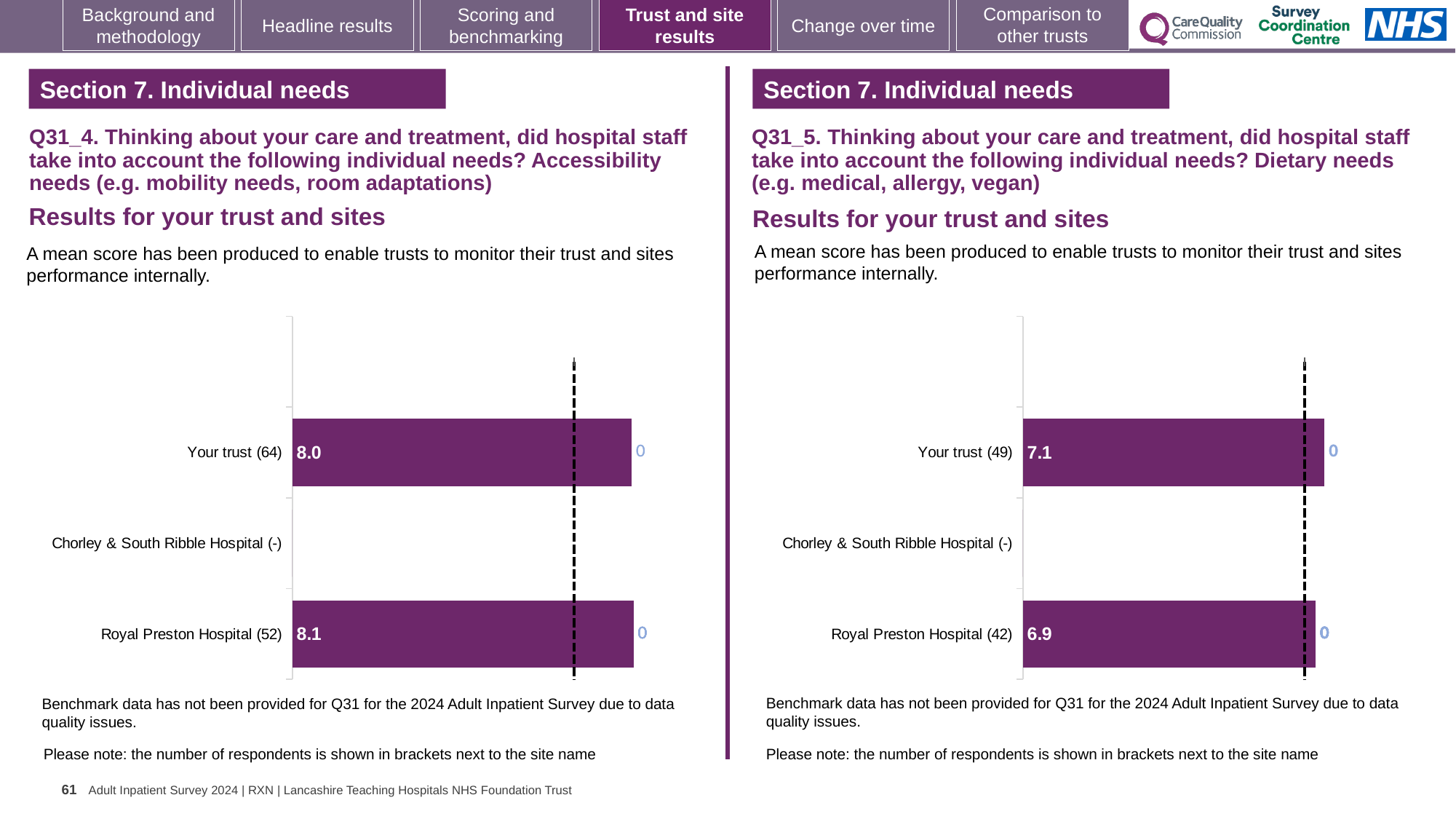
On the right chart (Q31_5, dietary needs), what is the mean score for Your trust? 7.1 On the right chart (Q31_5, dietary needs), how many respondents are shown in brackets for Royal Preston Hospital? 42 On the left chart (Q31_4, accessibility needs), what is the mean score for Royal Preston Hospital? 8.1 On the right chart (Q31_5, dietary needs), what is the mean score for Royal Preston Hospital? 6.9 On the right chart (Q31_5, dietary needs), which site or trust has the highest mean score? Your trust (49) On the right chart (Q31_5, dietary needs), what is the difference between the Your trust score and the Royal Preston Hospital score? 0.2 How many categories are listed on the vertical axis of the left chart (Q31_4, accessibility needs)? 3 On the left chart (Q31_4, accessibility needs), what is the mean score for Your trust? 8.0 What kind of chart is used on the right side of the slide (Q31_5, dietary needs)? Bar chart On the right chart (Q31_5, dietary needs), which of the plotted bars has the lowest mean score? Royal Preston Hospital (42) On the left chart (Q31_4, accessibility needs), what is the difference between the Royal Preston Hospital score and the Your trust score? 0.1 On the left chart (Q31_4, accessibility needs), which is larger: the score for Your trust or the score for Royal Preston Hospital? Royal Preston Hospital